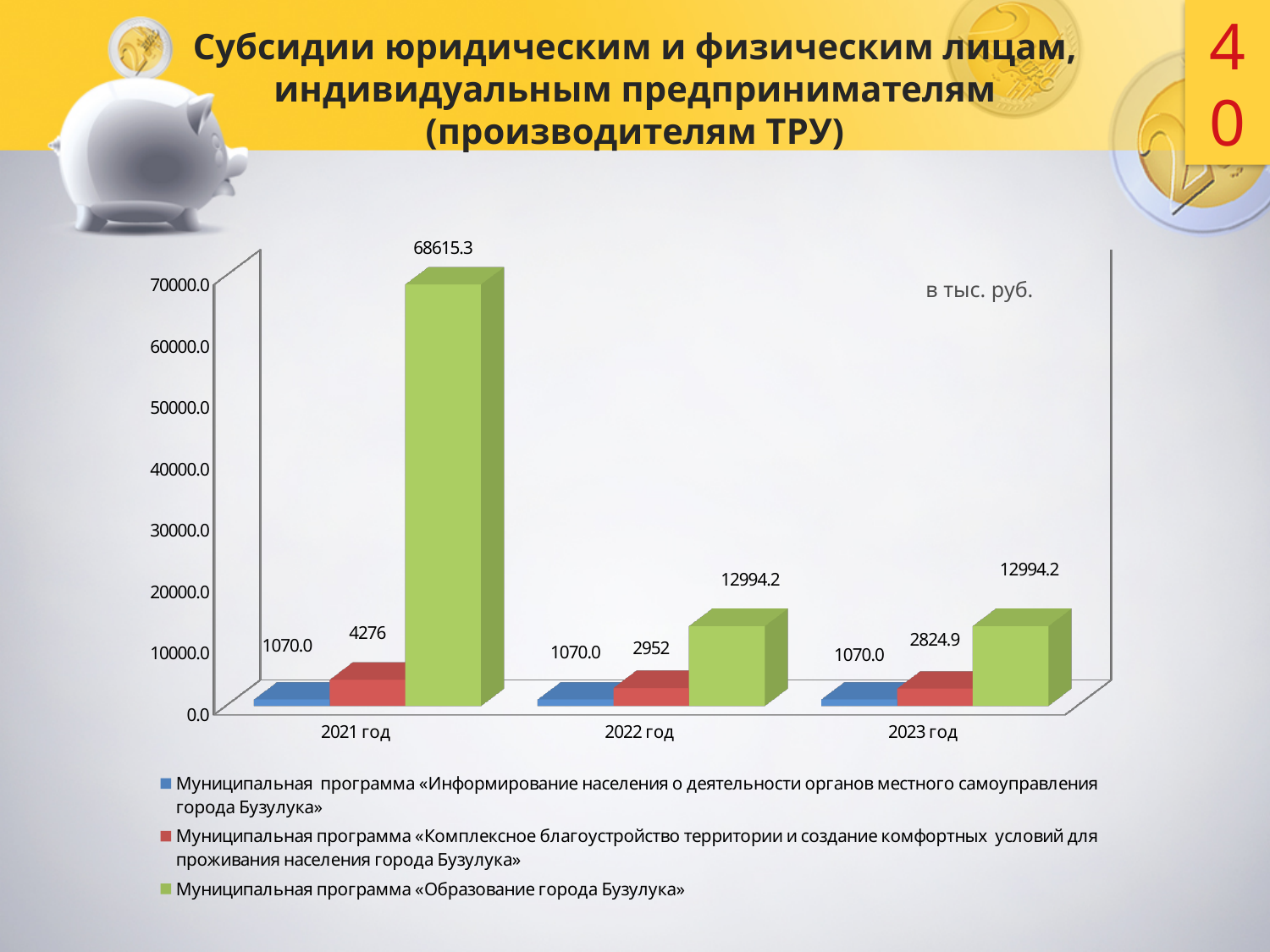
What kind of chart is shown on the slide? bar chart What is the difference between the «Образование города Бузулука» values for 2021 год and 2022 год? 55621.1 In which year is the value for «Муниципальная программа «Образование города Бузулука»» highest? 2021 год Which is larger in 2021 год: the value for «Комплексное благоустройство...» or the value for «Информирование населения...»? Комплексное благоустройство What is the value for «Муниципальная программа «Информирование населения о деятельности органов местного самоуправления города Бузулука»» in 2022 год? 1070.0 What is the value for «Муниципальная программа «Образование города Бузулука»» in 2021 год? 68615.3 How many series does the legend list? 3 How many years are shown on the x axis? 3 Is the value for «Образование города Бузулука» in 2021 год greater or less than 60000.0? greater In which year is the value for «Муниципальная программа «Комплексное благоустройство территории и создание комфортных условий для проживания населения города Бузулука»» lowest? 2023 год What is the value for «Муниципальная программа «Комплексное благоустройство территории и создание комфортных условий для проживания населения города Бузулука»» in 2022 год? 2952 What is the value for «Муниципальная программа «Комплексное благоустройство территории и создание комфортных условий для проживания населения города Бузулука»» in 2023 год? 2824.9